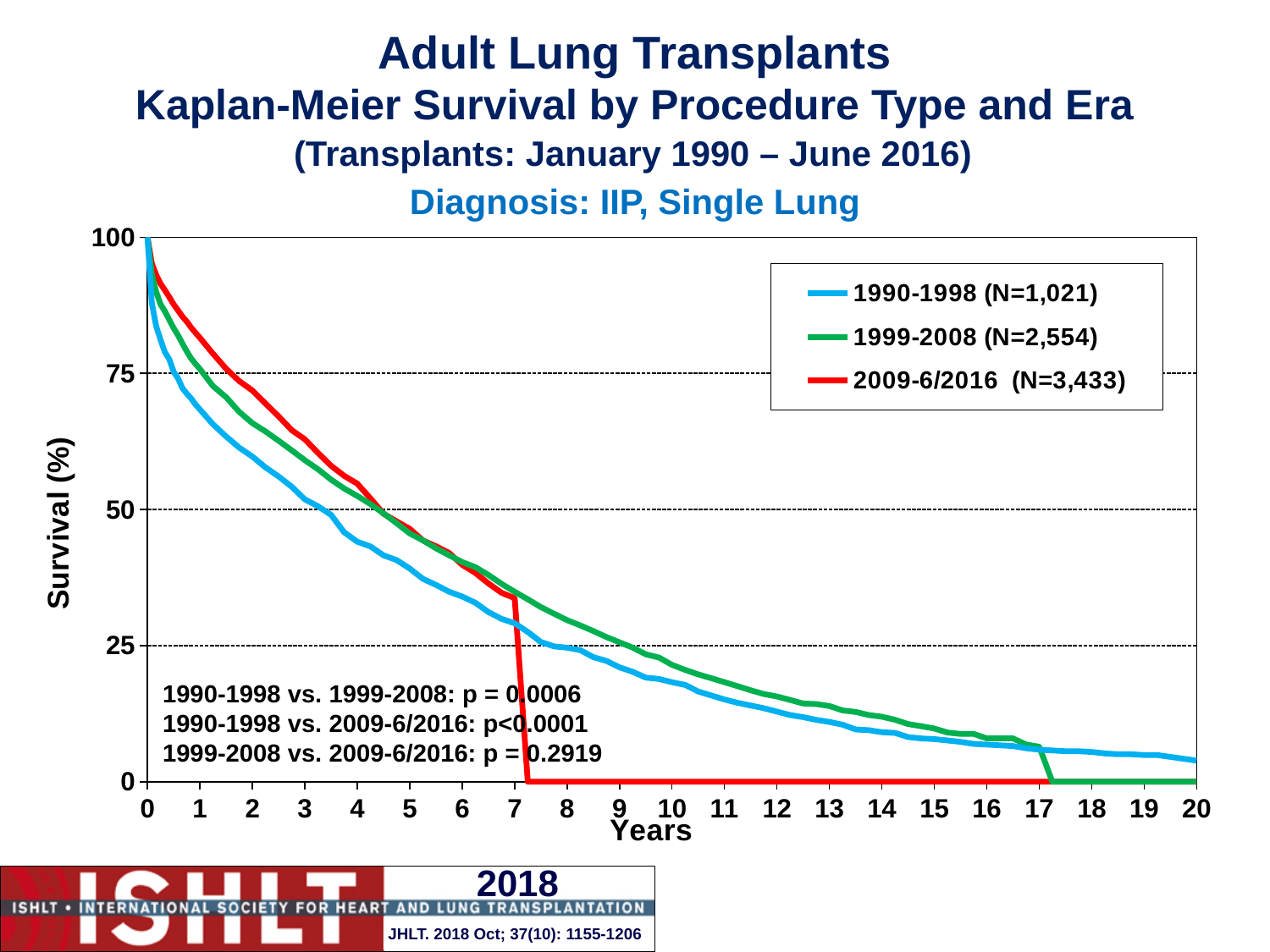
At year 1, which era has higher survival: 1990-1998 or 2009-6/2016? 2009-6/2016 What p-value is given for 1999-2008 vs. 2009-6/2016? p = 0.2919 What is the N for the 1990-1998 era shown in the legend? N=1,021 What p-value is given for 1990-1998 vs. 1999-2008? p = 0.0006 What is the N for the 1999-2008 era shown in the legend? N=2,554 Is the survival for the 2009-6/2016 era at year 1 greater or less than 75? greater Is the survival for the 1999-2008 era at year 10 greater or less than 25? less How many series does the legend list? 3 What kind of chart is shown on the slide? line chart Do the survival curves rise or fall as years increase? fall What is the N for the 2009-6/2016 era shown in the legend? N=3,433 Is the survival for the 1990-1998 era at year 1 greater or less than 75? less